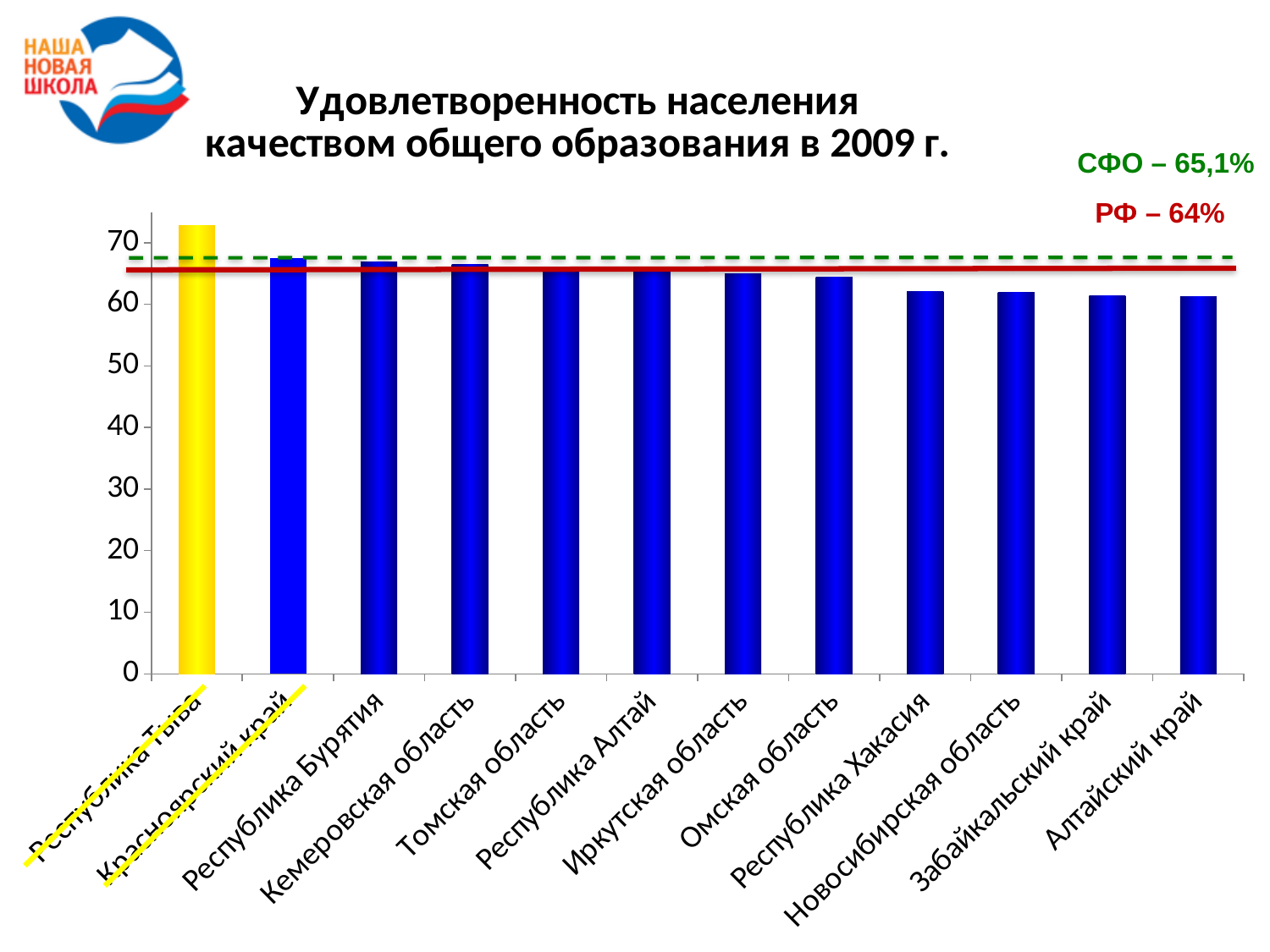
What colour is the bar for Республика Тыва? yellow Is the value for Республика Хакасия greater or less than 60? greater Which region has the highest bar in the chart? Республика Тыва Which is larger, the value for Республика Тыва or the value for Алтайский край? Республика Тыва Is the value for Алтайский край greater or less than 70? less What value does the slide give for СФО (the green dashed reference line)? 65,1% How many regions are shown on the x axis of the chart? 12 Do the bar values rise or fall from left to right along the x axis? fall Which is larger, the value for Красноярский край or the value for Забайкальский край? Красноярский край What value does the slide give for РФ (the red reference line)? 64% What kind of chart is shown on the slide? bar chart Is the value for Республика Тыва greater or less than 70? greater